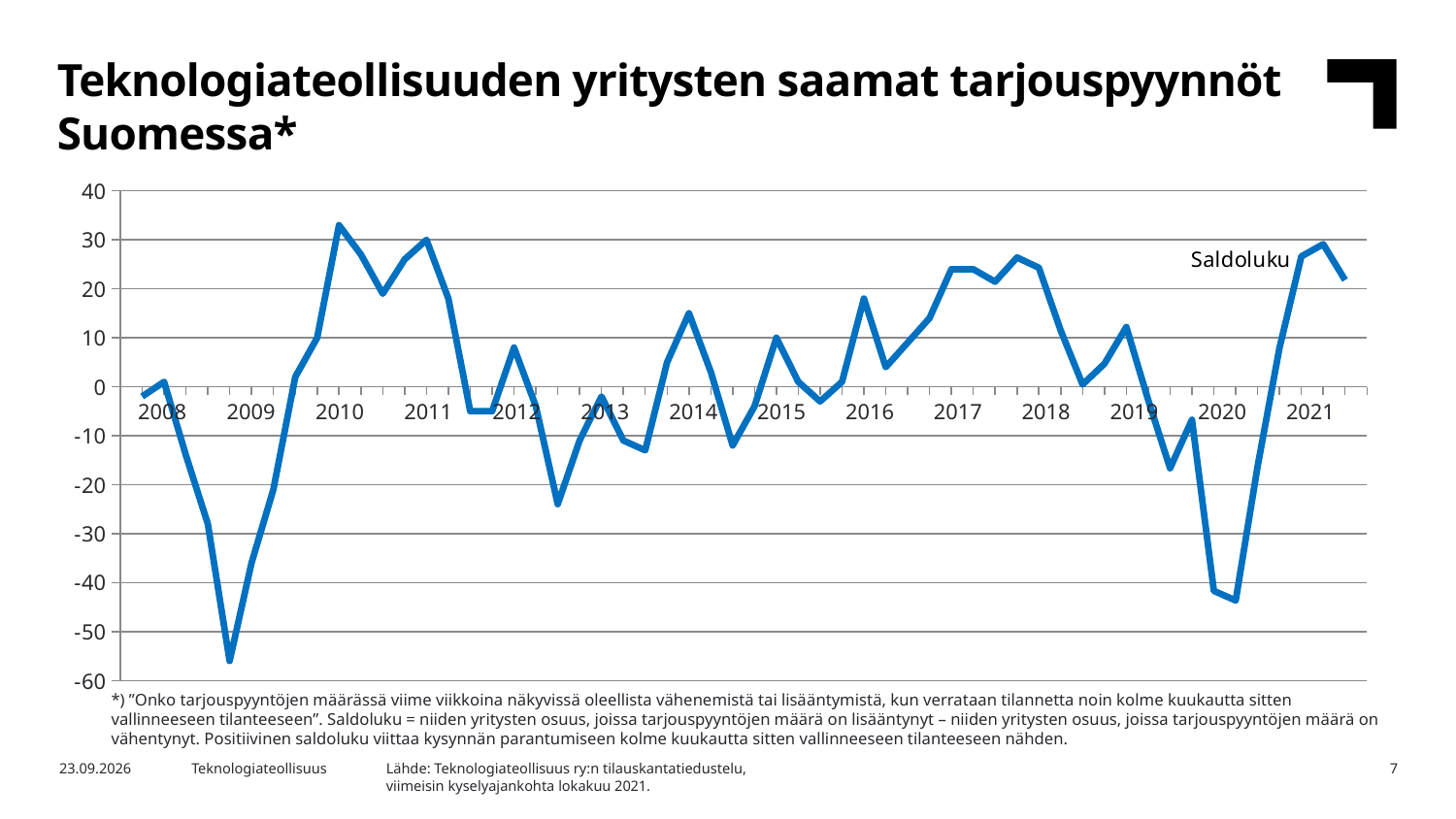
Which is lower, the dip in 2009 or the dip in 2020? 2009 What kind of chart is shown on the slide? line chart Is the peak value of the line in 2010 greater or less than 30? greater Does the line rise or fall from the low point in 2020 to the peak in 2021? rise Is the value of the line at the end of 2021 greater or less than 20? greater What is the name of the series plotted on the chart? Saldoluku Is the lowest value of the line in 2020 greater or less than -40? less Does the line rise or fall from the peak in 2010 to the low point in 2012? fall What is the title of the chart on the slide? Teknologiateollisuuden yritysten saamat tarjouspyynnöt Suomessa* How many years are labelled on the x axis of the chart? 14 In which year does the line reach its lowest point? 2009